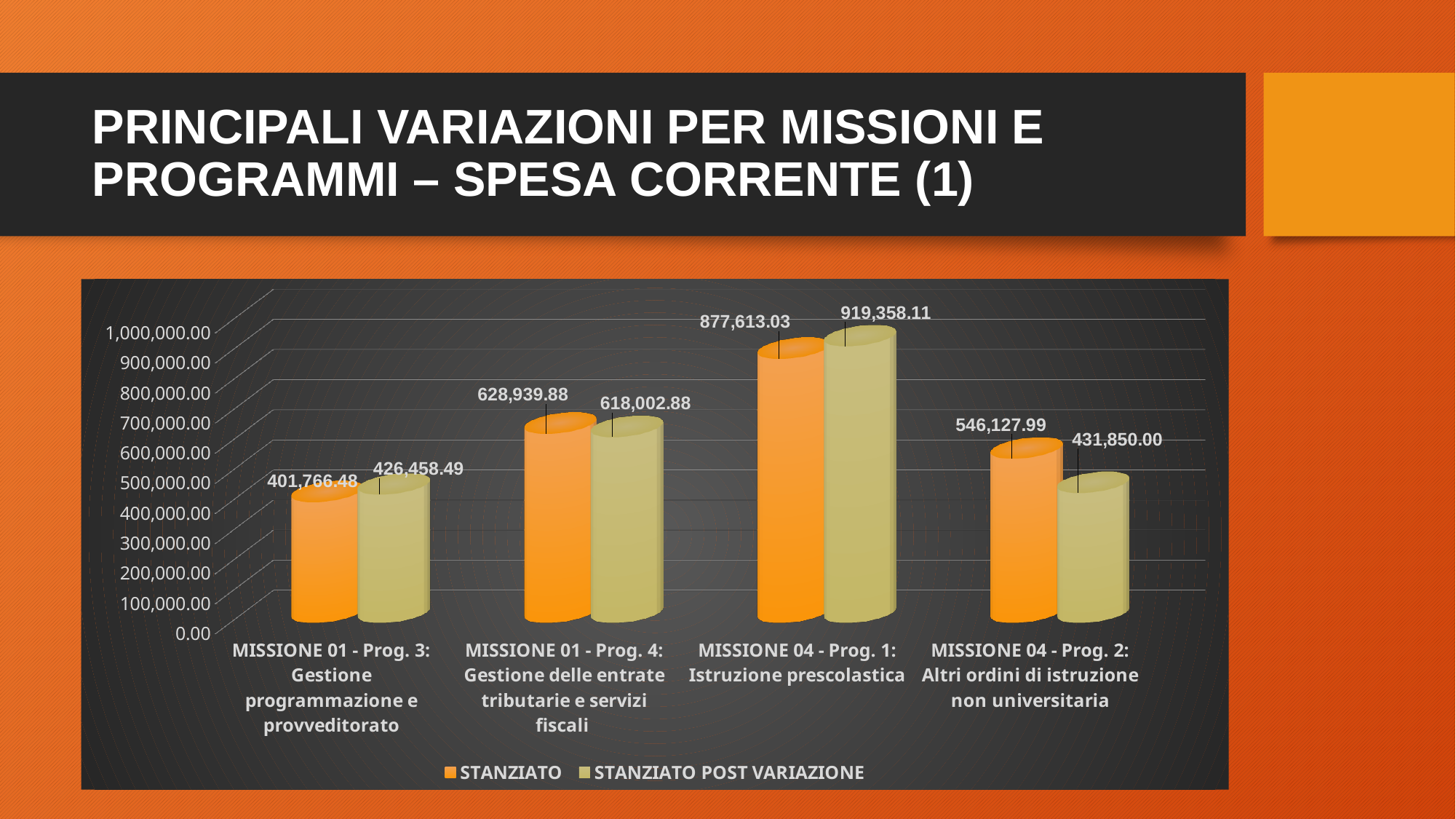
What is the STANZIATO POST VARIAZIONE value for MISSIONE 04 - Prog. 2: Altri ordini di istruzione non universitaria? 431,850.00 What is the difference between STANZIATO and STANZIATO POST VARIAZIONE for MISSIONE 04 - Prog. 2: Altri ordini di istruzione non universitaria? 114,277.99 How many categories are shown on the x axis of the chart? 4 Which category has the lowest STANZIATO value? MISSIONE 01 - Prog. 3: Gestione programmazione e provveditorato Which category has the highest STANZIATO POST VARIAZIONE value? MISSIONE 04 - Prog. 1: Istruzione prescolastica What kind of chart is shown on the slide? Bar chart What is the STANZIATO value for MISSIONE 04 - Prog. 1: Istruzione prescolastica? 877,613.03 For MISSIONE 01 - Prog. 4: Gestione delle entrate tributarie e servizi fiscali, which is larger: STANZIATO or STANZIATO POST VARIAZIONE? STANZIATO What is the difference between STANZIATO POST VARIAZIONE and STANZIATO for MISSIONE 04 - Prog. 1: Istruzione prescolastica? 41,745.08 What is the STANZIATO POST VARIAZIONE value for MISSIONE 01 - Prog. 3: Gestione programmazione e provveditorato? 426,458.49 Is the STANZIATO value for MISSIONE 04 - Prog. 2: Altri ordini di istruzione non universitaria greater or less than 500,000.00? greater How many series does the chart legend list? 2